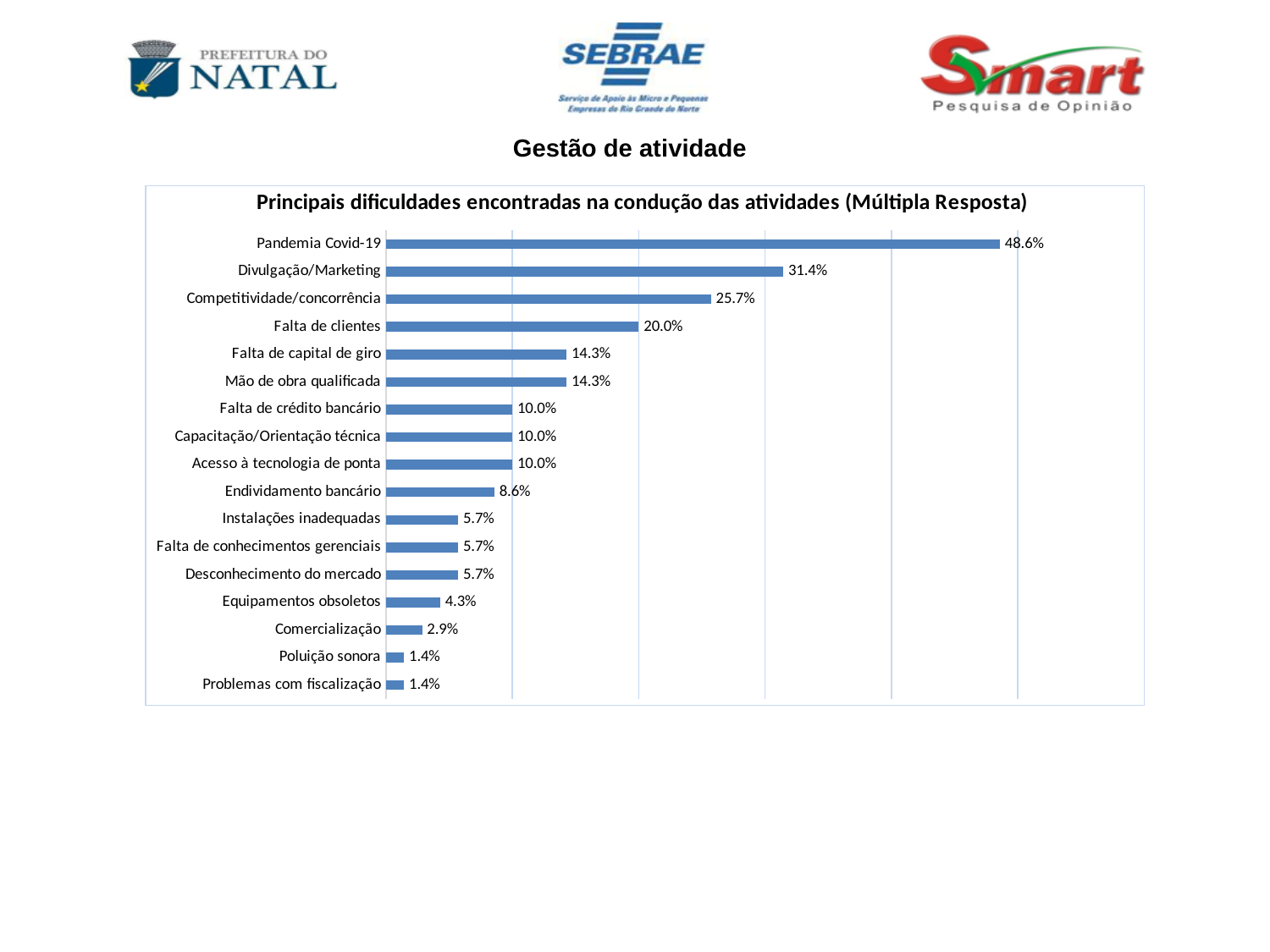
What is the value for Endividamento bancário? 8.6% What is the title of the chart? Principais dificuldades encontradas na condução das atividades (Múltipla Resposta) Which difficulty has the highest percentage? Pandemia Covid-19 What is the value for Divulgação/Marketing? 31.4% What type of chart is shown on the slide? Bar chart What percentage is shown for Falta de clientes? 20.0% What percentage is shown for Equipamentos obsoletos? 4.3% Which is larger, the value for Falta de capital de giro or the value for Falta de crédito bancário? Falta de capital de giro What percentage is shown for Pandemia Covid-19? 48.6% What is the difference between the values for Pandemia Covid-19 and Divulgação/Marketing? 17.2% What is the difference between the values for Competitividade/concorrência and Falta de clientes? 5.7% How many difficulty categories are plotted in the chart? 17